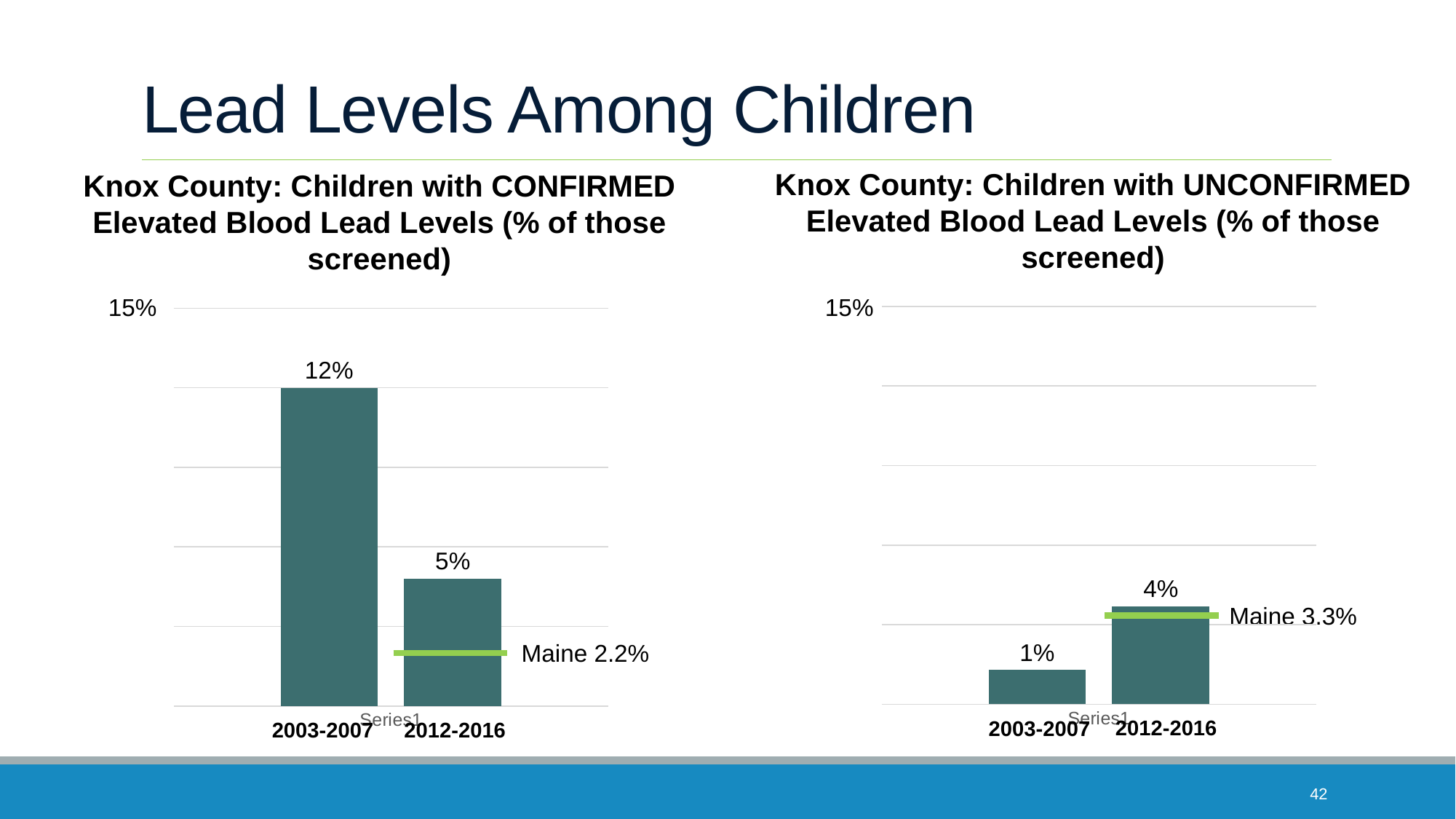
In the CONFIRMED Elevated Blood Lead Levels chart, which period has the higher value? 2003-2007 In the UNCONFIRMED Elevated Blood Lead Levels chart, what is the value for 2003-2007? 1% What type of chart is the UNCONFIRMED Elevated Blood Lead Levels chart? bar chart In the CONFIRMED Elevated Blood Lead Levels chart, what is the Maine reference value shown? Maine 2.2% In the UNCONFIRMED Elevated Blood Lead Levels chart, do the values rise or fall from 2003-2007 to 2012-2016? rise In the UNCONFIRMED Elevated Blood Lead Levels chart, what is the value for 2012-2016? 4% In the CONFIRMED Elevated Blood Lead Levels chart, what is the difference between the 2003-2007 and 2012-2016 values? 7% In the CONFIRMED Elevated Blood Lead Levels chart, what is the value for 2012-2016? 5% In the UNCONFIRMED Elevated Blood Lead Levels chart, what is the Maine reference value shown? Maine 3.3% In the CONFIRMED Elevated Blood Lead Levels chart, what is the value for 2003-2007? 12% How many bars are plotted in the CONFIRMED Elevated Blood Lead Levels chart? 2 In the UNCONFIRMED Elevated Blood Lead Levels chart, which period has the lower value? 2003-2007